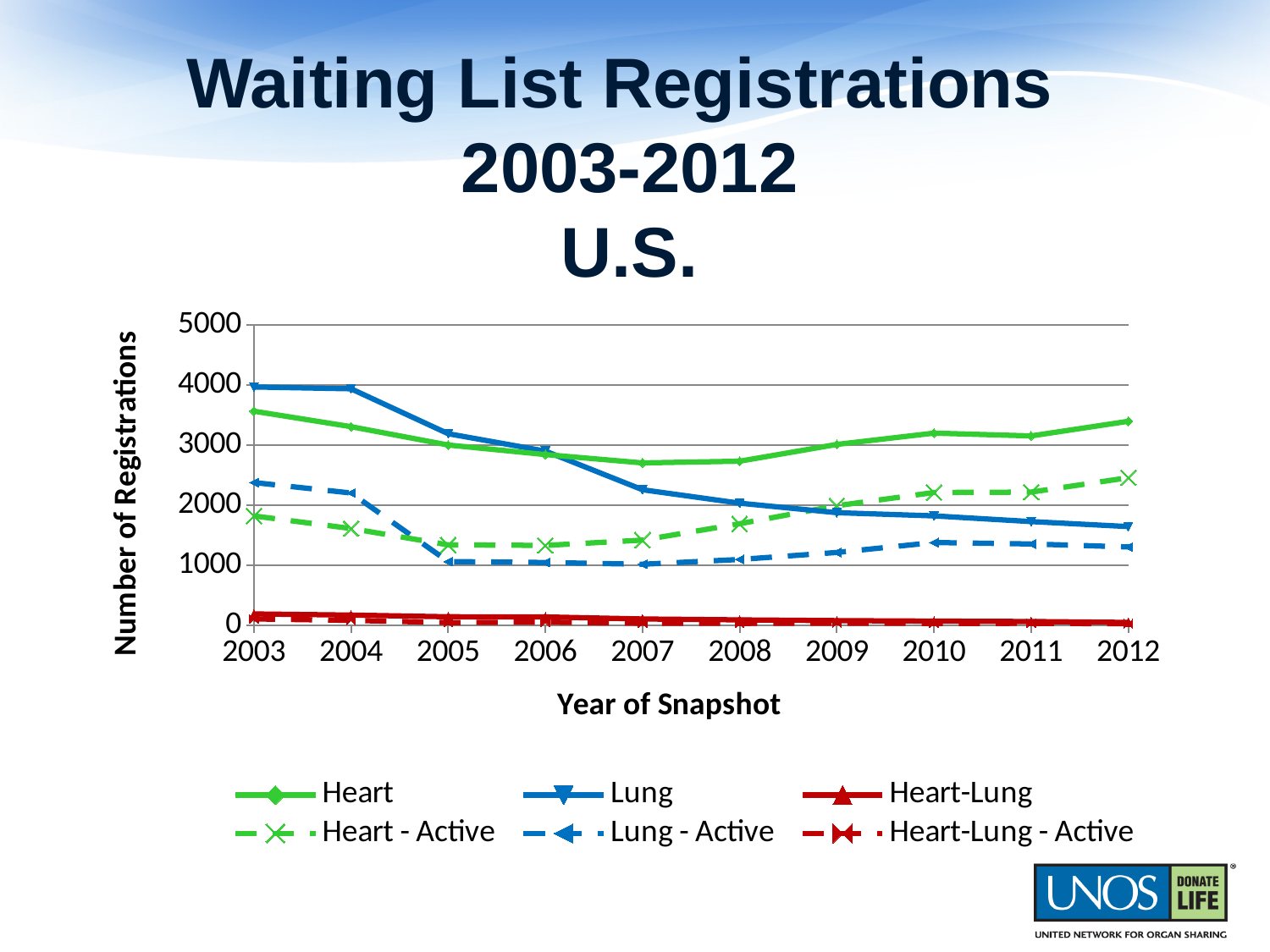
Is the value for Heart-Lung in 2003 greater or less than 1000? less Is the value for Heart - Active in 2012 greater or less than 2000? greater How many series does the legend list? 6 What is the label of the y axis? Number of Registrations Is the value for Lung in 2003 greater or less than 3000? greater What kind of chart is shown on the slide? line chart How many years are plotted along the x axis? 10 In 2003, which is larger, Heart or Lung? Lung Does the Lung series rise or fall from 2003 to 2012? fall In 2012, which is larger, Heart or Lung? Heart